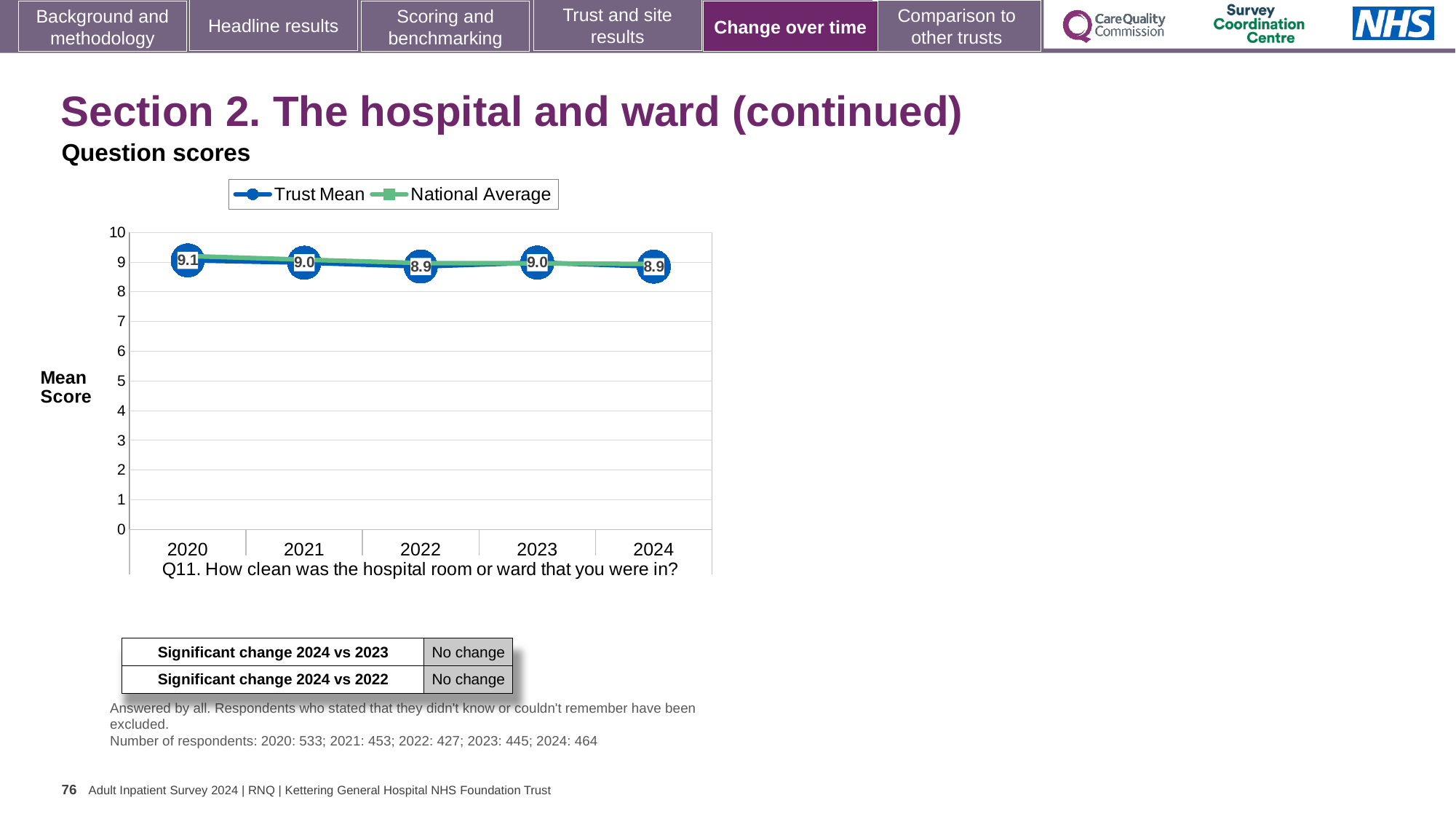
What is the Trust Mean score for 2020? 9.1 Is the Trust Mean score for 2021 greater or less than 8? greater In which year is the Trust Mean score highest? 2020 What is the label on the y axis of the chart? Mean Score What is the Trust Mean score for 2022? 8.9 What is the Trust Mean score for 2023? 9.0 What is the difference between the Trust Mean score in 2020 and in 2024? 0.2 Which question does the chart relate to, as labelled below the x axis? Q11. How clean was the hospital room or ward that you were in? What is the Trust Mean score for 2024? 8.9 How many series does the chart legend list? 2 How many years are shown on the x axis of the chart? 5 What kind of chart is shown on the slide? line chart